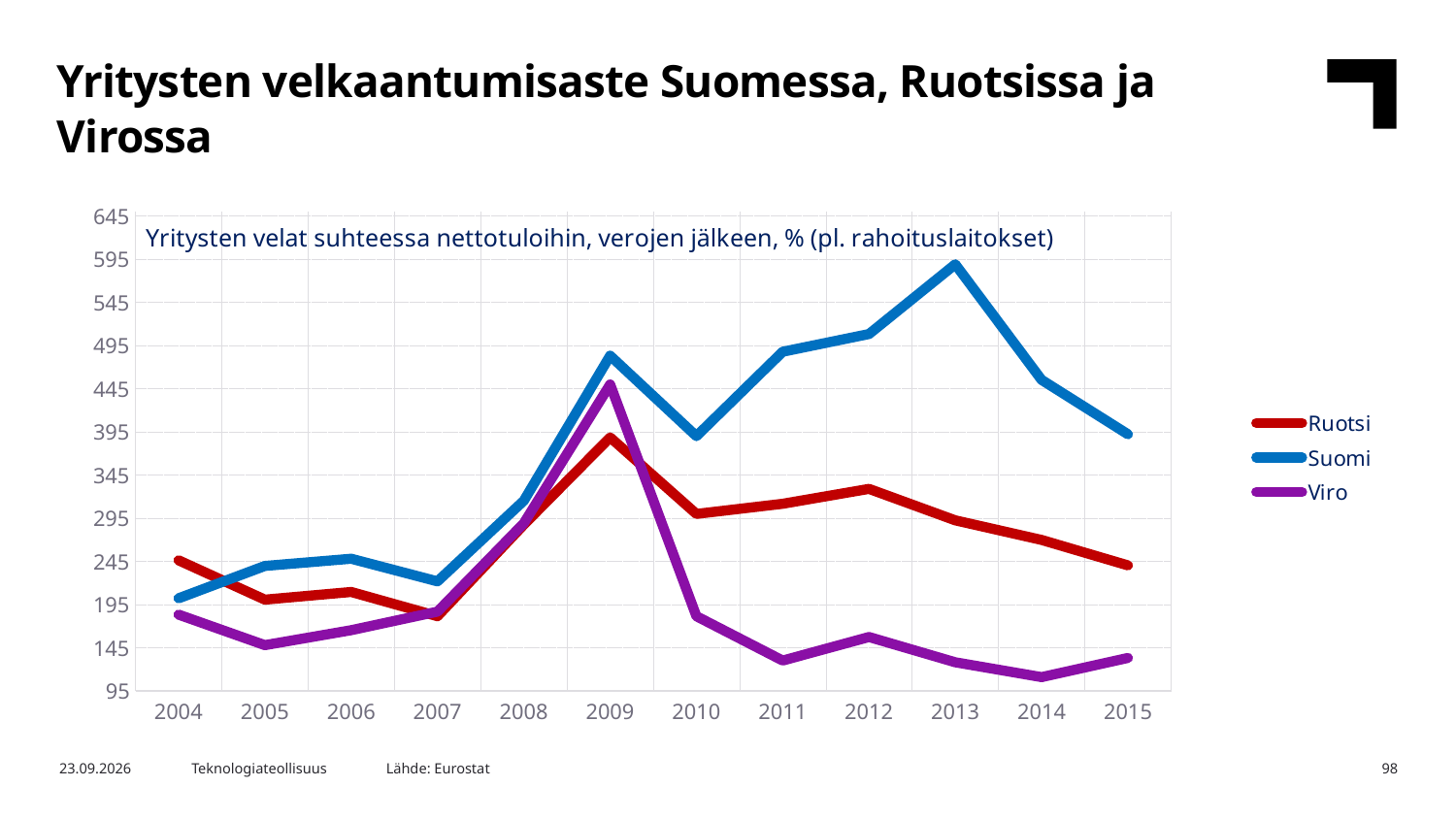
Which is larger in 2009, the value for Suomi or the value for Ruotsi? Suomi How many series does the legend list? 3 In which year does the Suomi line reach its highest value? 2013 Which series has the highest value in 2013? Suomi What kind of chart is shown on the slide? line chart Which is larger in 2004, the value for Ruotsi or the value for Suomi? Ruotsi Is the value for Suomi in 2013 greater or less than 545? greater How many years are shown on the x axis? 12 In which year does the Ruotsi line reach its highest value? 2009 Is the value for Viro in 2011 greater or less than 145? less In which year does the Viro line reach its lowest value? 2014 Does the Suomi line rise or fall from 2013 to 2015? fall